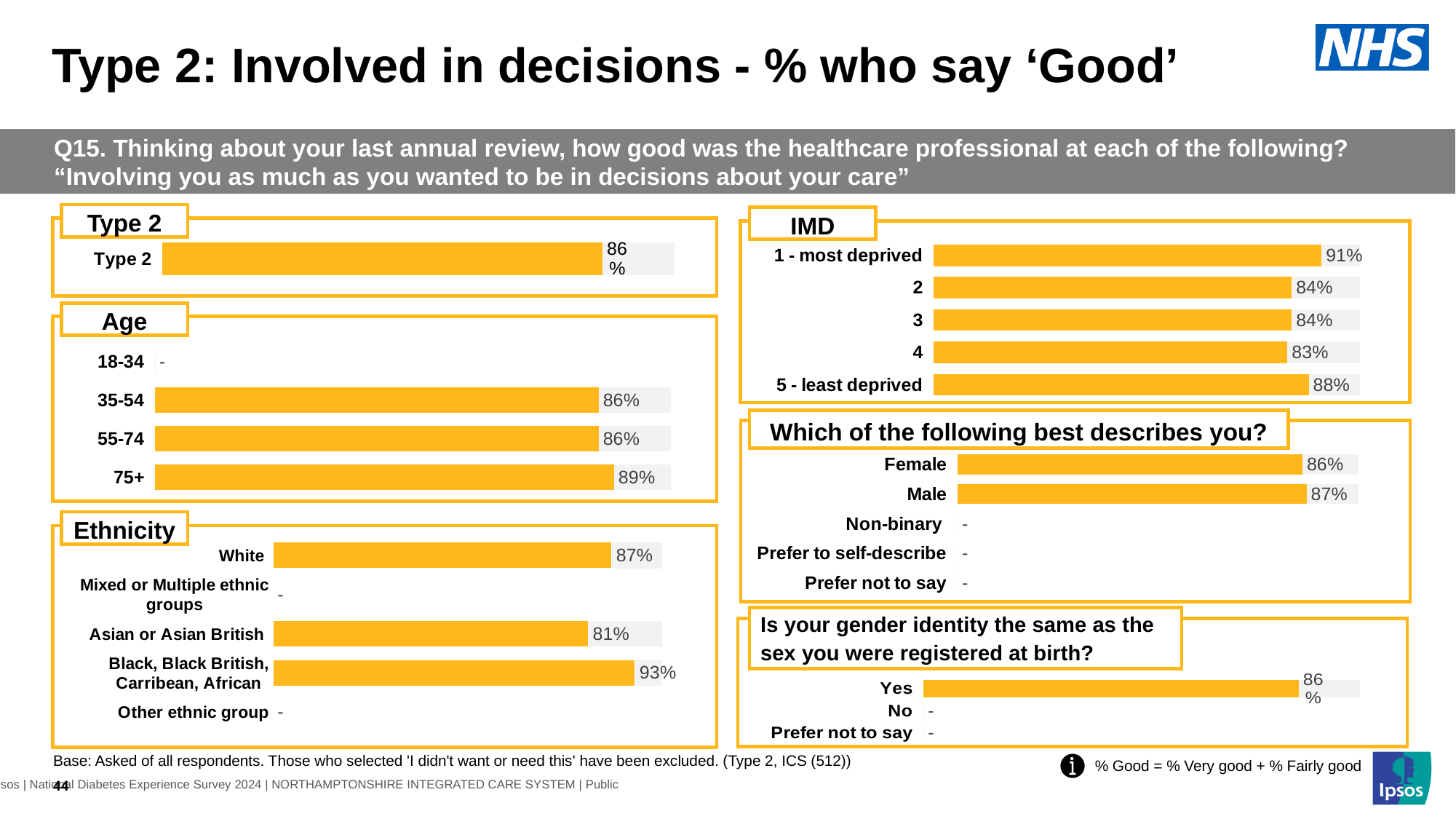
In the Ethnicity chart, which ethnic group has the highest value? Black, Black British, Carribean, African In the IMD chart, what is the difference between the values for 1 - most deprived and 5 - least deprived? 3% In the IMD chart, which category has the lowest value? 4 In the Ethnicity chart, what is the difference between the values for Black, Black British, Carribean, African and Asian or Asian British? 12% In the 'Which of the following best describes you?' chart, which is larger, the value for Female or Male? Male In the Type 2 chart, what is the value for Type 2? 86% In the IMD chart, what is the value for 1 - most deprived? 91% In the Age chart, what is the value for 75+? 89% What kind of chart is the IMD chart? Bar chart In the Age chart, which age group has the highest value? 75+ In the 'Is your gender identity the same as the sex you were registered at birth?' chart, what is the value for Yes? 86% In the Ethnicity chart, what is the value for Asian or Asian British? 81%